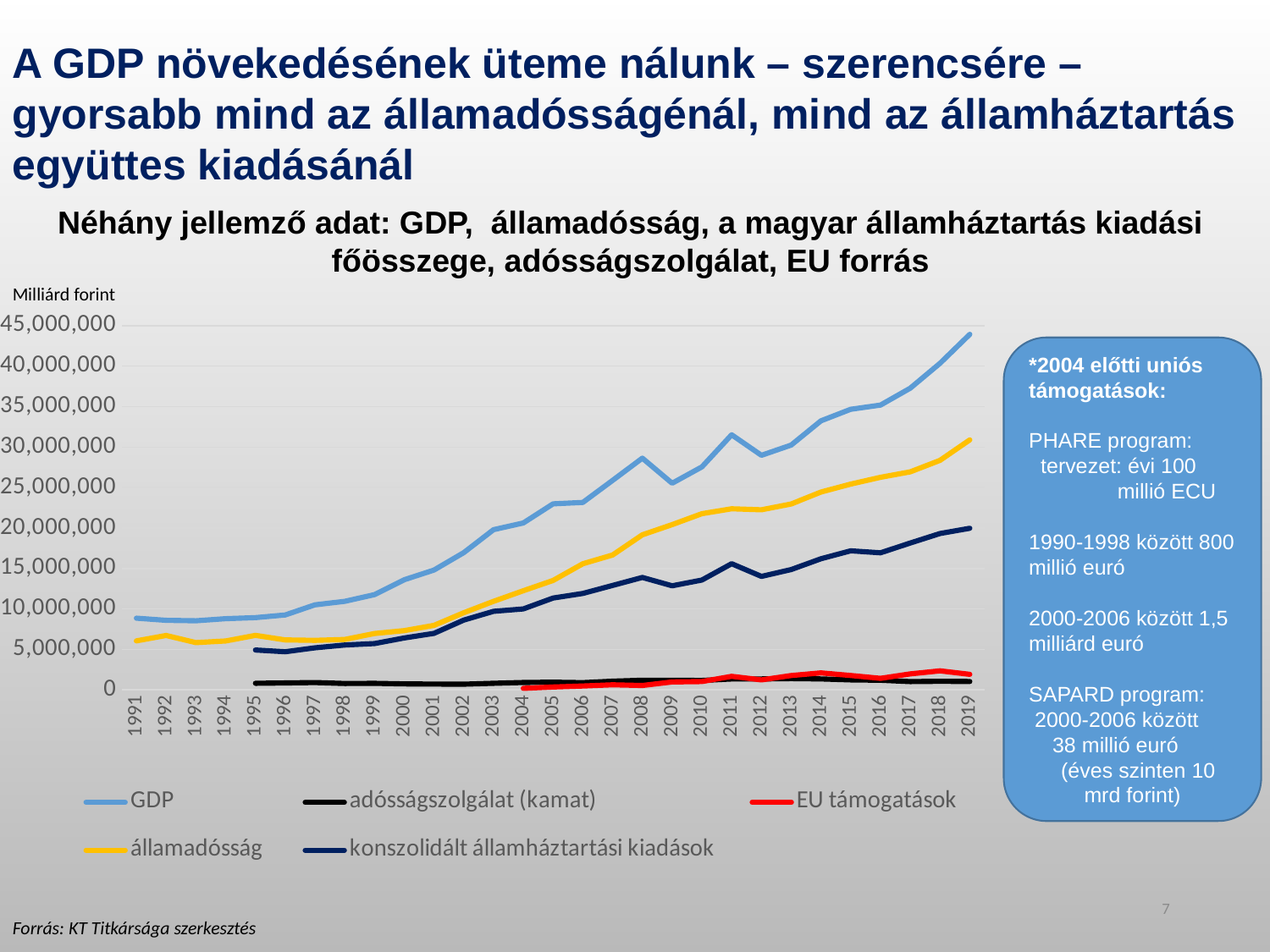
How many years are shown along the x axis of the chart? 29 How many series does the chart legend list? 5 Is the GDP value for 2019 greater or less than 40,000,000? greater Is the konszolidált államháztartási kiadások value for 2019 greater or less than 25,000,000? less Is the GDP value for 1991 greater or less than 10,000,000? less In 2019, which is larger: GDP or államadósság? GDP What kind of chart is shown on the slide? line chart What unit is given for the y axis of the chart? Milliárd forint Does the GDP line generally rise or fall from 1991 to 2019? rise Which series has the lowest value in 2019? adósságszolgálat (kamat) Which series has the highest value in 2019? GDP